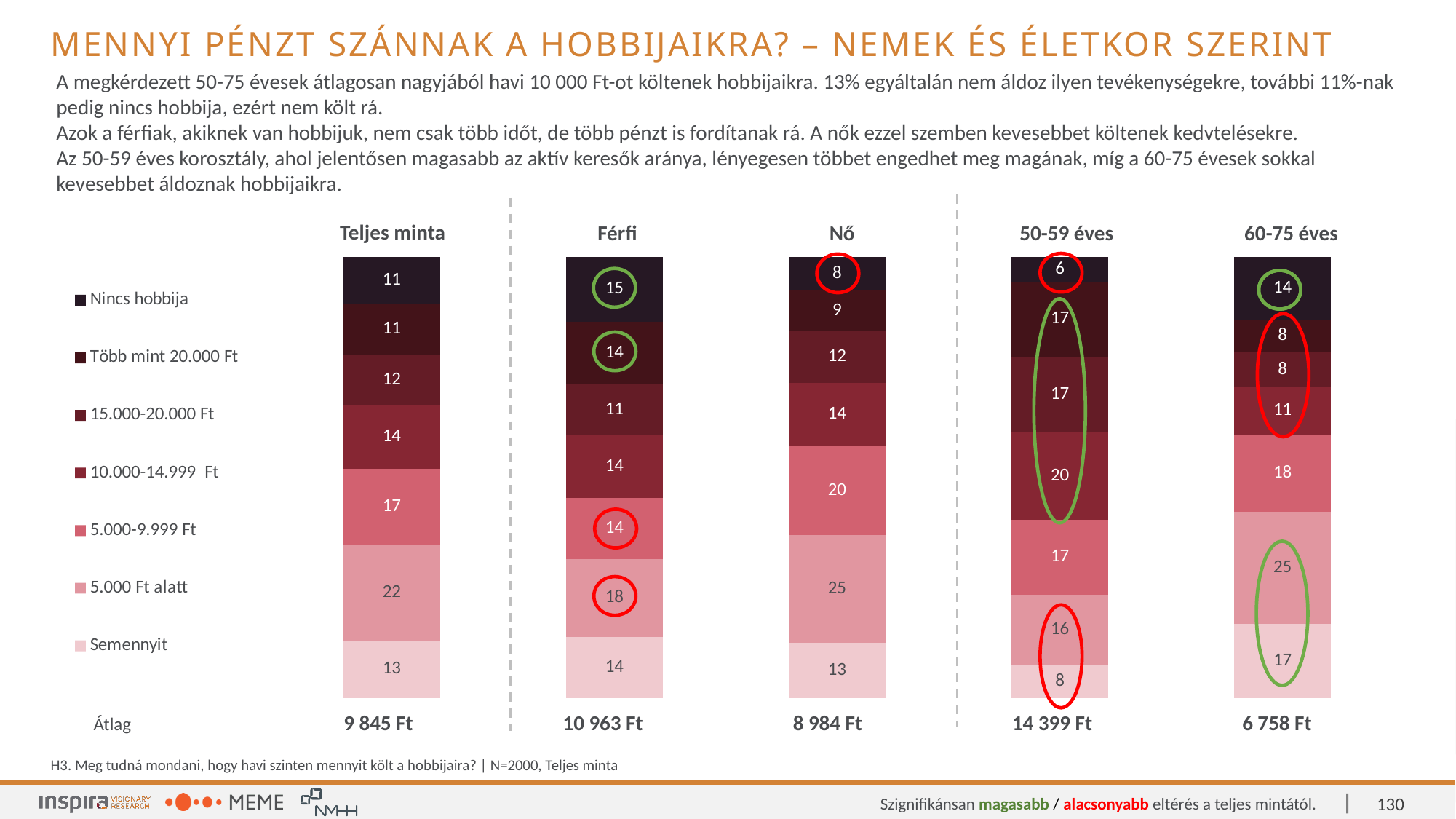
What is the total of the 'Teljes minta' stacked bar? 100 How many bars (groups) are plotted in the chart? 5 What is the difference between the '5.000 Ft alatt' values for 'Nő' and 'Férfi'? 7 What is the value of the '5.000 Ft alatt' segment for the '60-75 éves' bar? 25 What is the value of the 'Nincs hobbija' segment for the 'Férfi' bar? 15 How many series does the legend list? 7 What is the value of the 'Semennyit' segment for the 'Nő' bar? 13 What is the 'Átlag' (average) shown for the '50-59 éves' group? 14 399 Ft What kind of chart is shown on the slide? stacked bar chart Which group has the highest 'Nincs hobbija' value? Férfi Which is larger: the 'Több mint 20.000 Ft' value for '50-59 éves' or for '60-75 éves'? 50-59 éves Which group has the lowest 'Átlag' value shown below the bars? 60-75 éves